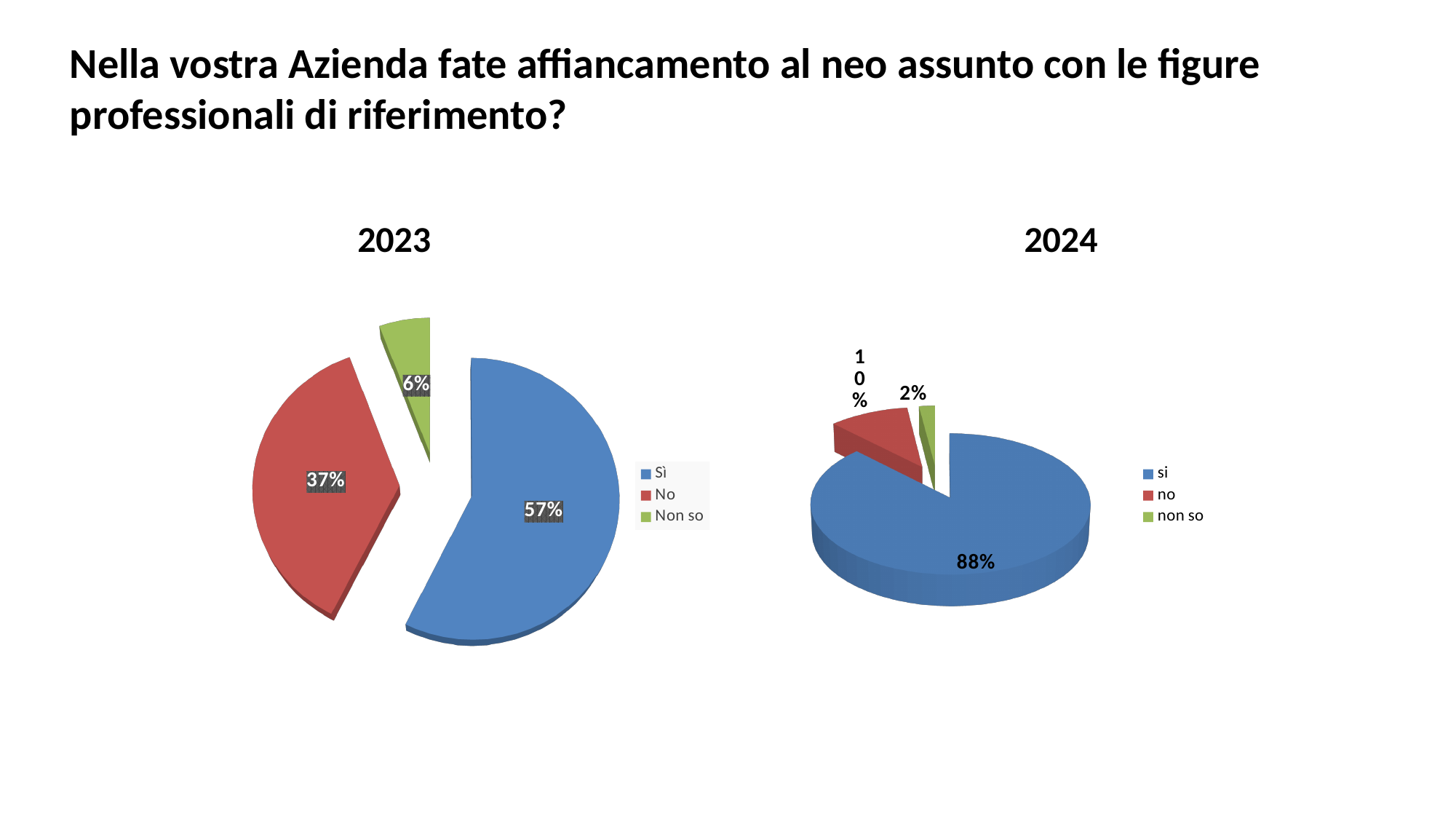
In the 2024 chart, what percentage of respondents answered 'non so'? 2% In the 2023 chart, what is the difference between the 'Sì' and 'No' shares? 20 percentage points In the 2024 chart, which response has the largest share? si In the 2023 chart, what percentage of respondents answered 'No'? 37% How many slices does the 2024 pie chart have? 3 In the 2023 chart, what colour is the 'No' slice? Red In the 2024 chart, what percentage of respondents answered 'si'? 88% What type of chart is used for the 2023 data? Pie chart In the 2023 chart, what percentage of respondents answered 'Sì'? 57% Is the 'Sì' share larger in the 2023 chart or the 2024 chart? 2024 In the 2023 chart, which response has the smallest share? Non so In the 2024 chart, what percentage of respondents answered 'no'? 10%